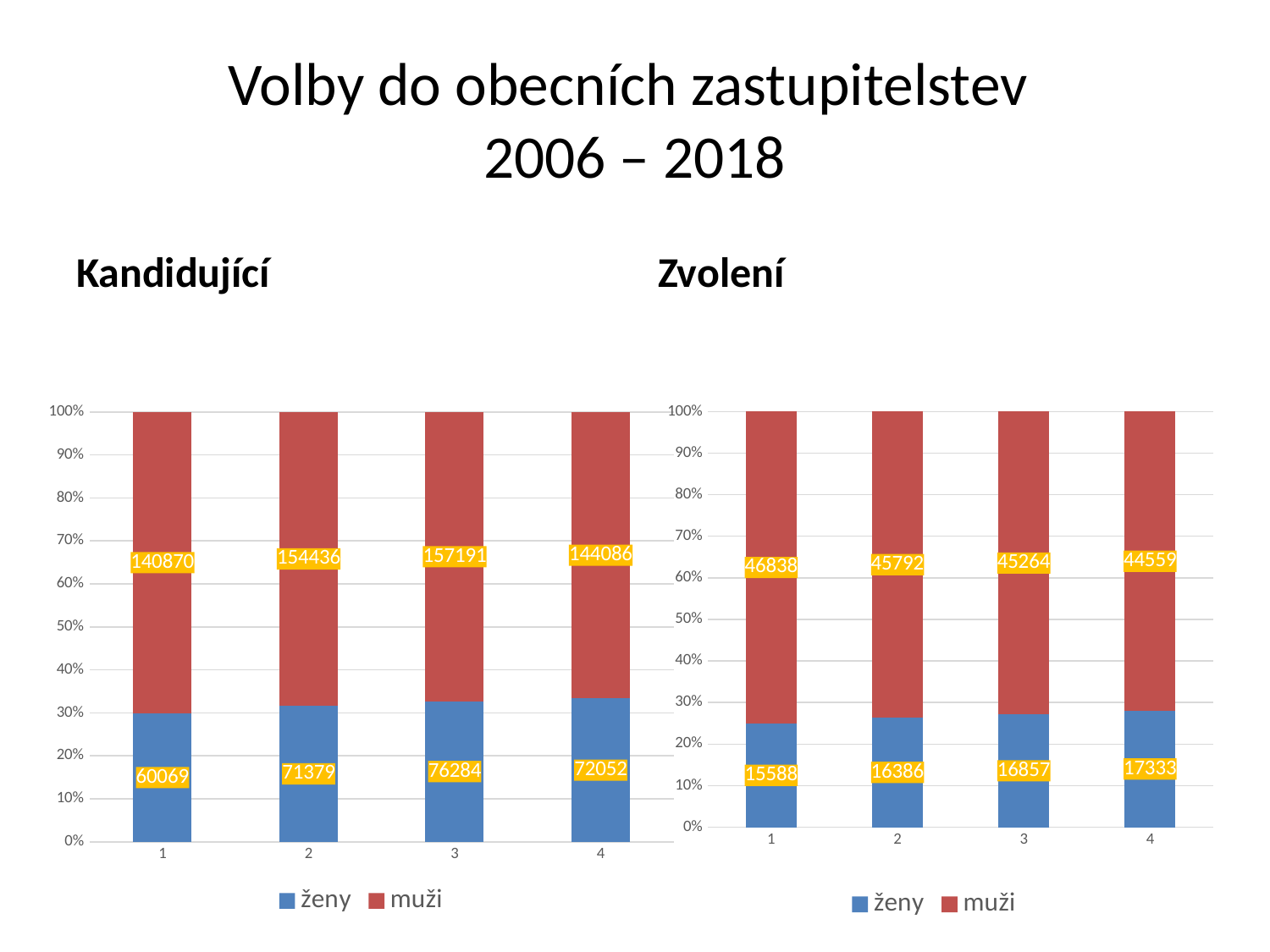
In the Zvolení chart, do the ženy values rise or fall from category 1 to category 4? rise What kind of chart is the Kandidující chart? stacked bar chart In the Kandidující chart, what is the value for ženy in category 3? 76284 In the Zvolení chart, what is the value for muži in category 1? 46838 In the Zvolení chart, which category has the lowest value for ženy? 1 How many categories are shown on the x axis of the Kandidující chart? 4 In the Kandidující chart, which category has the highest value for muži? 3 How many series does the legend of the Zvolení chart list? 2 In the Kandidující chart, which is larger: the ženy value for category 2 or for category 4? category 4 In the Zvolení chart, what is the difference between the muži values for category 1 and category 4? 2279 In the Zvolení chart, is the ženy share of the bar for category 1 greater or less than 30%? less In the Kandidující chart, what is the total of ženy and muži for category 1? 200939